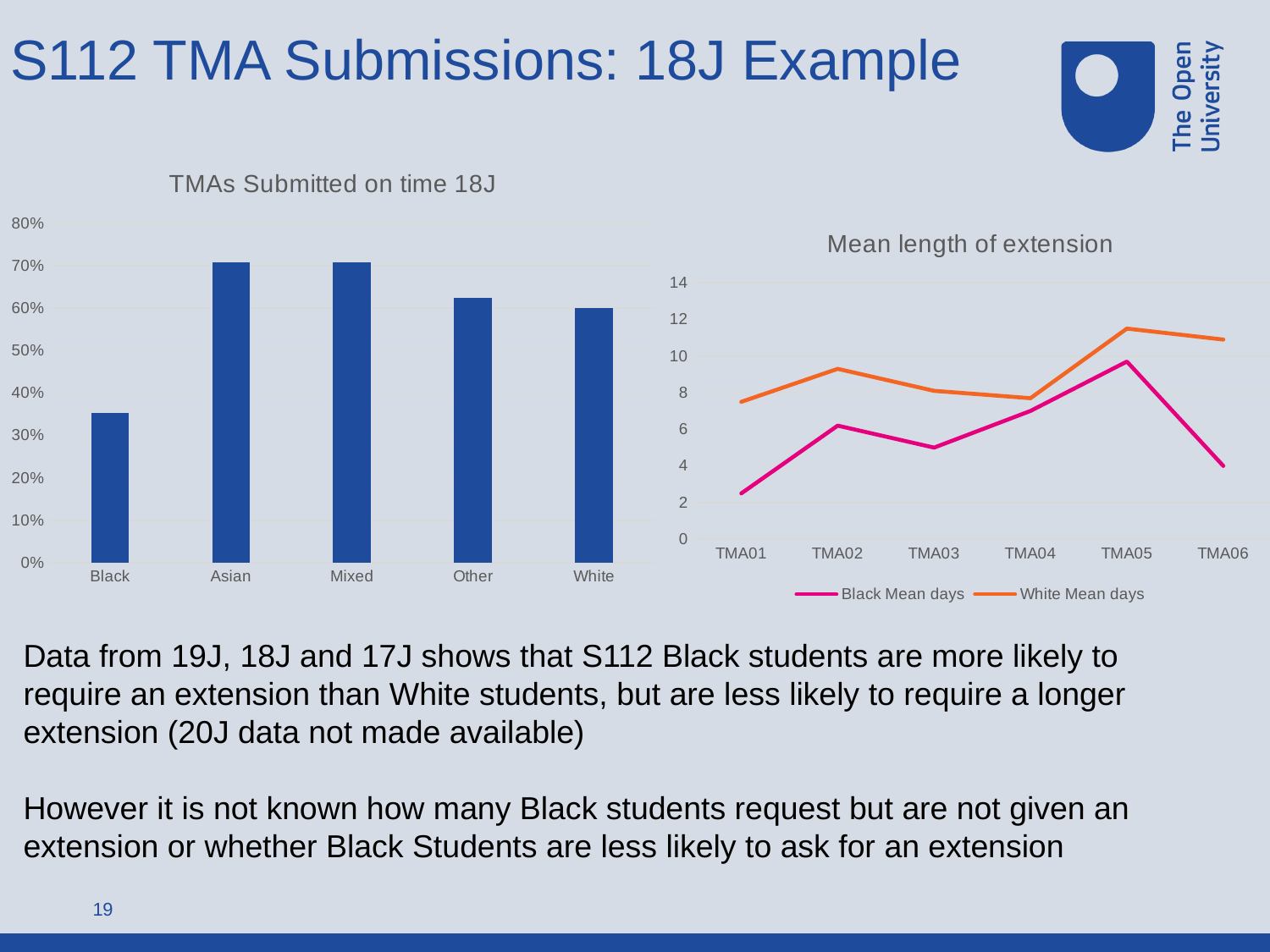
In the 'TMAs Submitted on time 18J' chart, is the value for Black greater or less than 40%? less In the 'TMAs Submitted on time 18J' chart, which is larger, the value for Black or the value for White? White What kind of chart is 'Mean length of extension'? line chart What kind of chart is 'TMAs Submitted on time 18J'? bar chart How many categories are shown in the 'TMAs Submitted on time 18J' chart? 5 In the 'TMAs Submitted on time 18J' chart, which category has the lowest value? Black How many series does the legend of the 'Mean length of extension' chart list? 2 In the 'TMAs Submitted on time 18J' chart, is the value for Asian greater or less than 60%? greater In the 'Mean length of extension' chart, is the Black Mean days value at TMA01 greater or less than 4? less In the 'Mean length of extension' chart, at which TMA does Black Mean days reach its highest value? TMA05 In the 'Mean length of extension' chart, does Black Mean days rise or fall from TMA05 to TMA06? fall How many TMAs are plotted along the x axis of the 'Mean length of extension' chart? 6